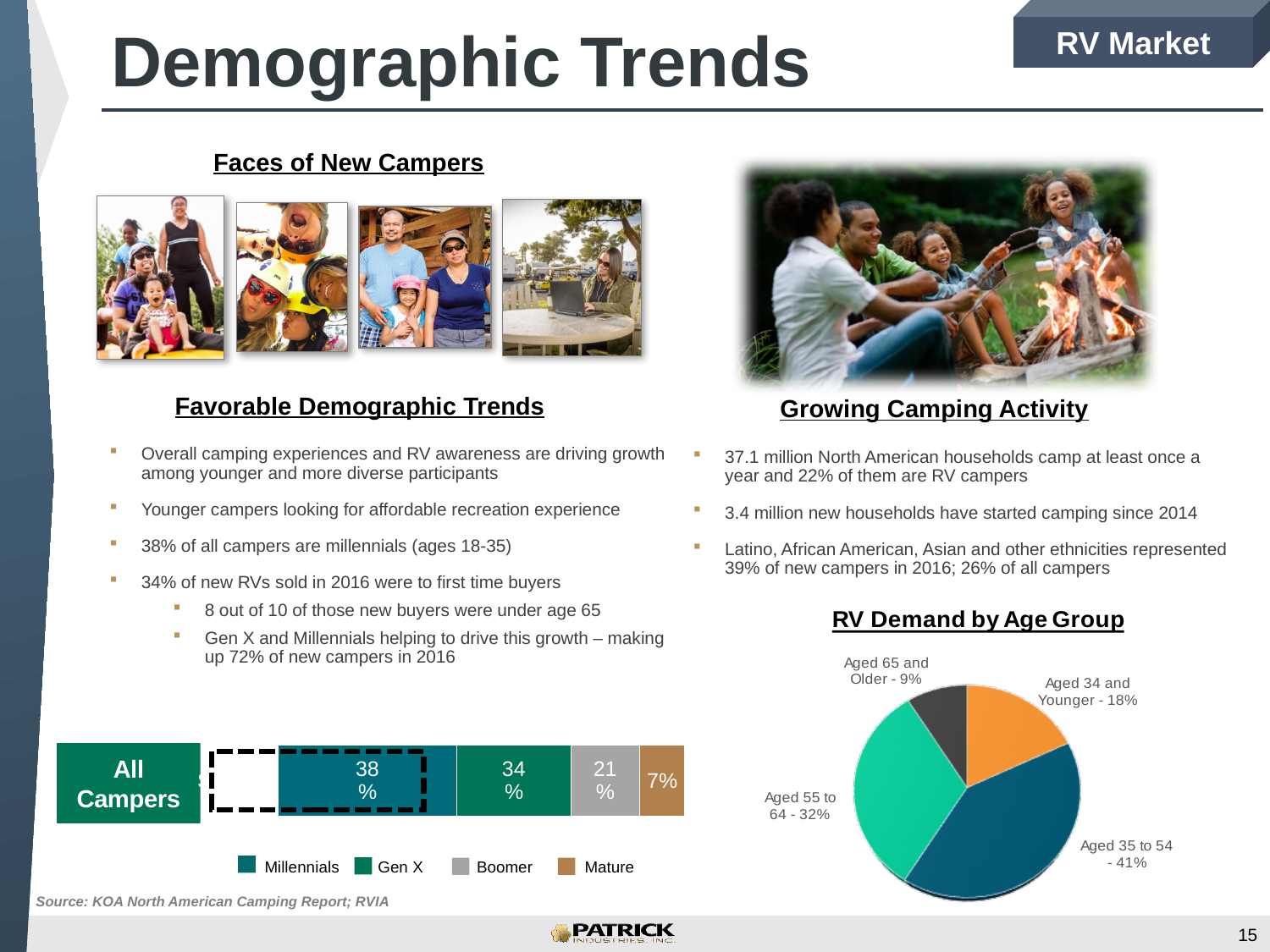
In the 'All Campers' bar chart, what percentage is shown for Gen X? 34% In the 'RV Demand by Age Group' pie chart, what share is shown for Aged 35 to 54? 41% In the 'RV Demand by Age Group' pie chart, which age group has the largest share? Aged 35 to 54 What kind of chart is 'RV Demand by Age Group'? Pie chart In the 'RV Demand by Age Group' pie chart, which age group has the smallest share? Aged 65 and Older In the 'All Campers' bar chart, what percentage is shown for Mature? 7% In the 'RV Demand by Age Group' pie chart, how many percentage points larger is the Aged 55 to 64 share than the Aged 34 and Younger share? 14 In the 'All Campers' bar chart, how many series does the legend list? 4 In the 'RV Demand by Age Group' pie chart, what share is shown for Aged 65 and Older? 9% In the 'All Campers' bar chart, which generation has the largest share? Millennials In the 'RV Demand by Age Group' pie chart, how many age groups are shown? 4 In the 'All Campers' bar chart, how many percentage points larger is the Millennials share than the Boomer share? 17